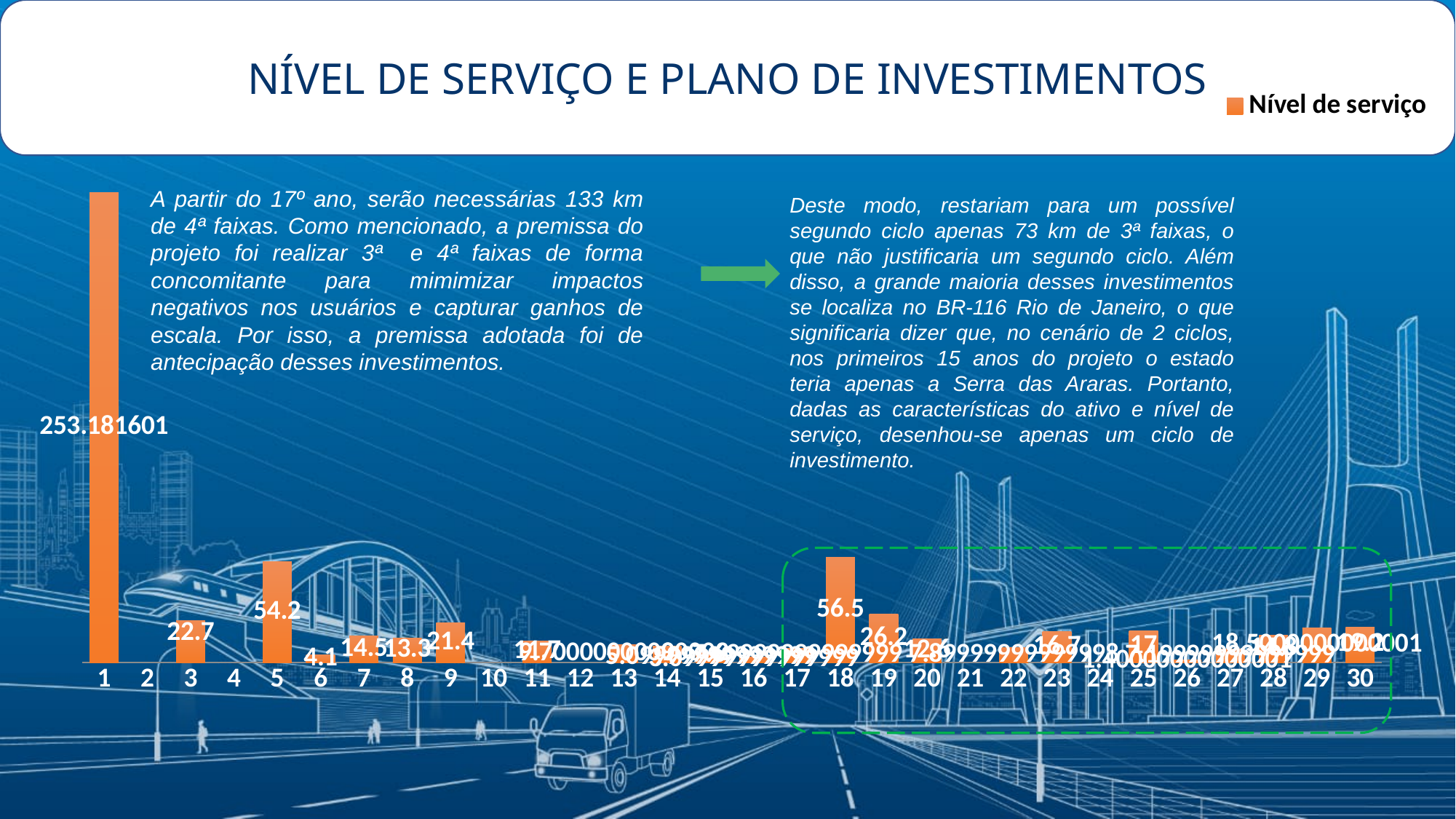
What is the value for category 18? 56.5 What kind of chart is shown on the slide? bar chart What is the value for category 5? 54.2 What is the value for category 19? 26.2 Which category has the highest value? 1 Which is larger, the value for category 3 or the value for category 9? category 3 How many series does the legend list? 1 What is the value for category 1? 253.181601 What is the difference between the values for category 18 and category 5? 2.3 What is the value for category 6? 4.1 What is the name of the series shown in the legend? Nível de serviço How many categories are shown on the x axis? 30